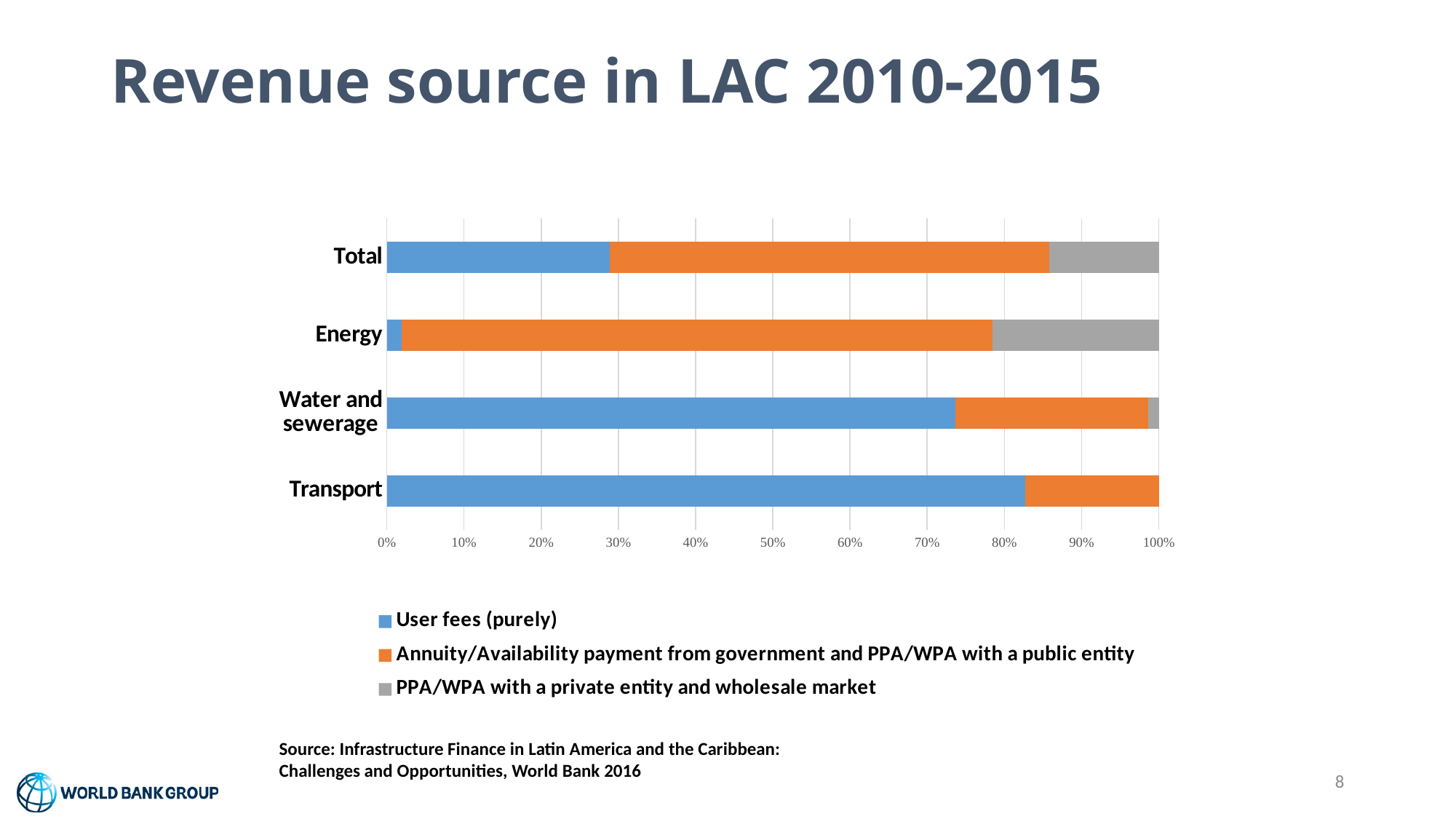
Is the User fees (purely) share for Energy greater or less than 10%? less Which has a larger share of User fees (purely): Energy or Water and sewerage? Water and sewerage Which category has the smallest share of User fees (purely)? Energy Which category has the largest share of PPA/WPA with a private entity and wholesale market? Energy Is the User fees (purely) share for Total greater or less than 40%? less Is the User fees (purely) share for Water and sewerage greater or less than 60%? greater What kind of chart is shown on the slide? Stacked bar chart What colour represents User fees (purely) in the chart? Blue Which category has the largest share of User fees (purely)? Transport How many series does the legend list? 3 How many categories (sectors) are plotted on the chart? 4